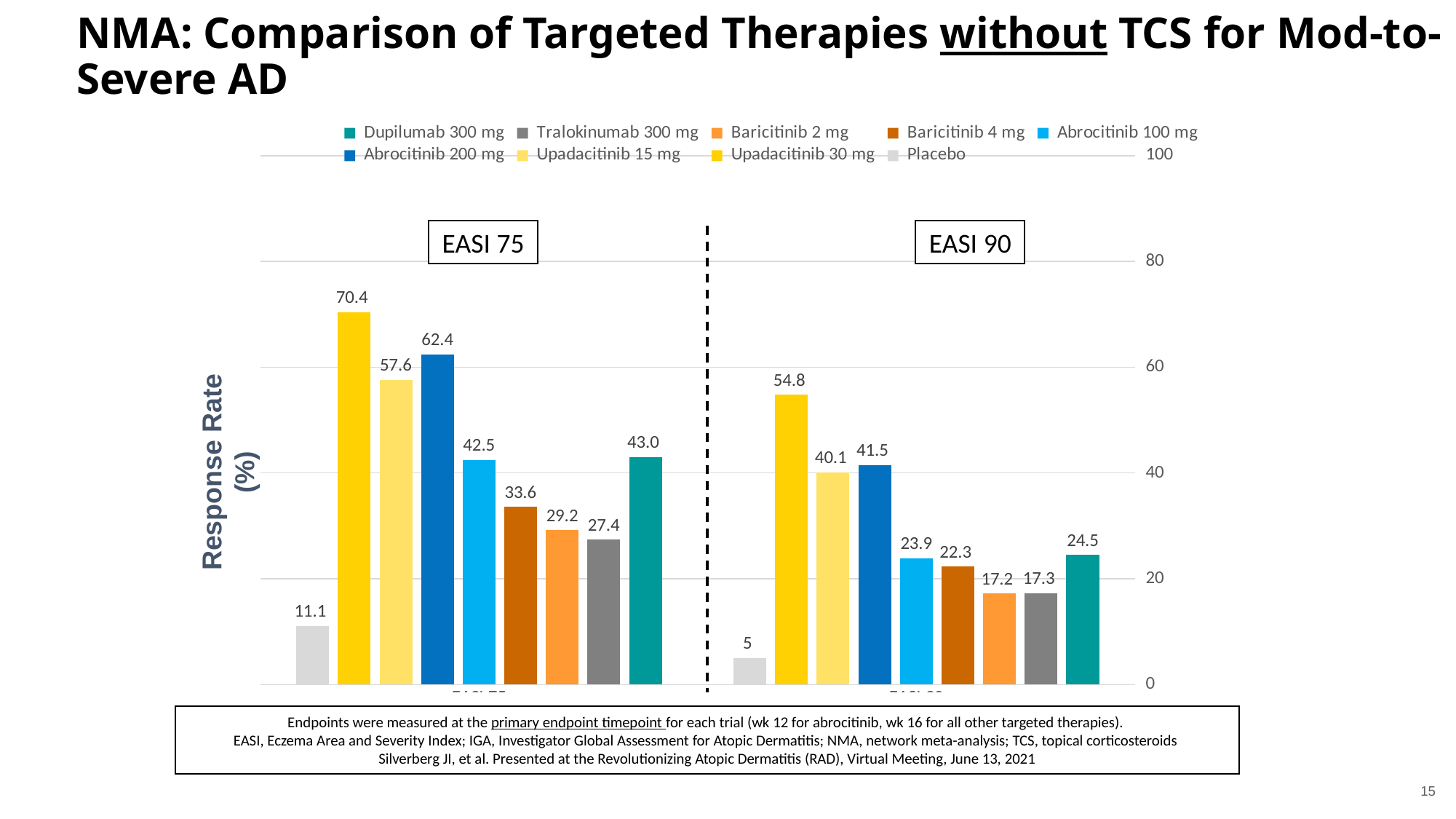
How many series does the legend list? 9 What is the difference between the EASI 75 and EASI 90 response rates for Upadacitinib 30 mg? 15.6 What is the EASI 90 response rate for Placebo? 5 Which therapy has the highest EASI 90 response rate? Upadacitinib 30 mg Which bar is lowest in the EASI 75 group? Placebo Which is larger for EASI 75: Abrocitinib 100 mg or Baricitinib 4 mg? Abrocitinib 100 mg What is the EASI 90 response rate for Dupilumab 300 mg? 24.5 What is the EASI 75 response rate for Abrocitinib 200 mg? 62.4 What is the label of the y axis? Response Rate (%) What kind of chart is shown on the slide? Bar chart What is the EASI 75 response rate for Upadacitinib 30 mg? 70.4 What is the difference between the EASI 75 response rates of Dupilumab 300 mg and Tralokinumab 300 mg? 15.6